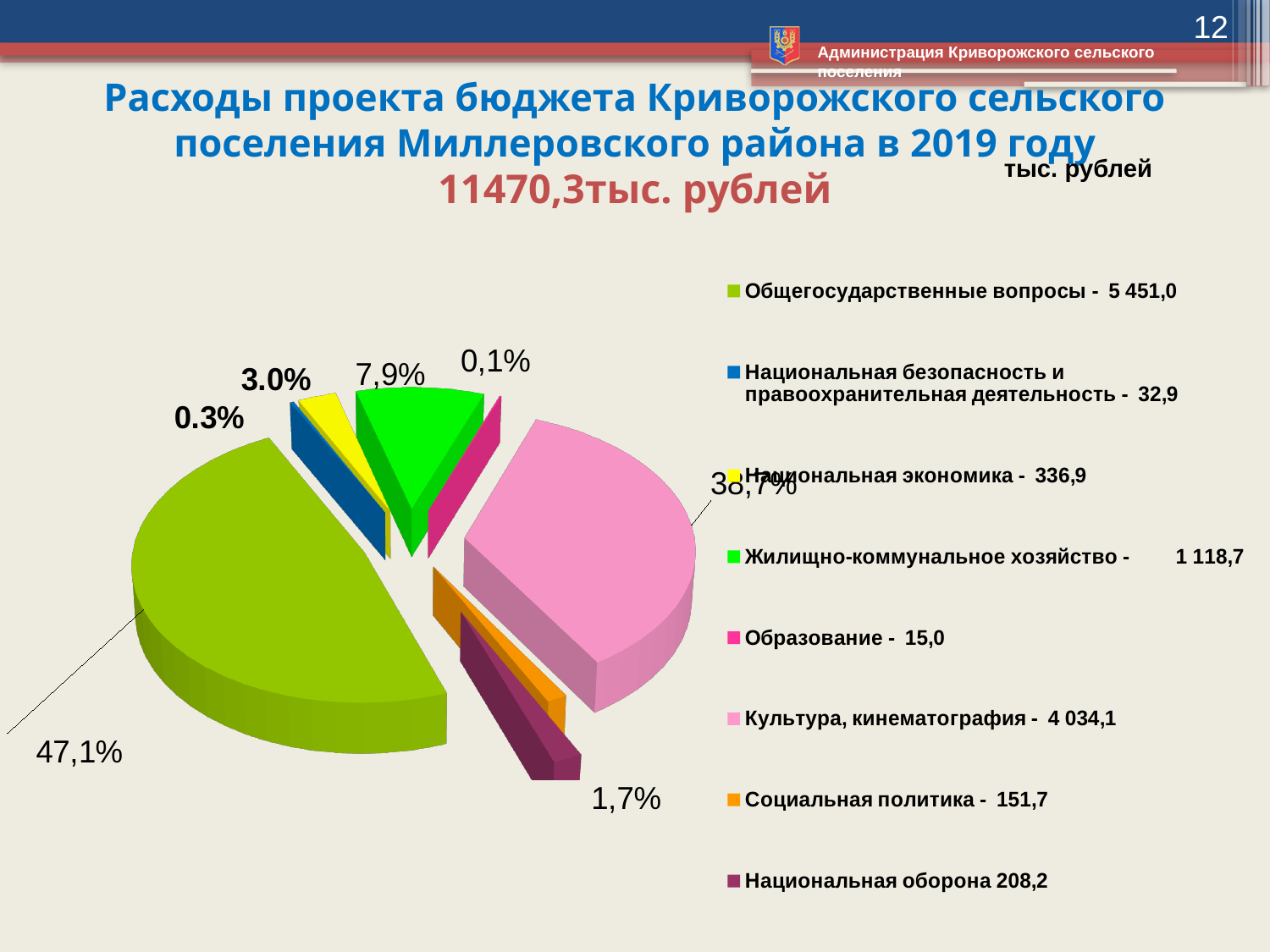
What share of the pie does Жилищно-коммунальное хозяйство take, according to its data label? 7,9% What value is given in the legend for Образование? 15,0 What kind of chart is shown on the slide? pie chart Which category has the smallest value in the pie chart? Образование What value is given in the legend for Общегосударственные вопросы? 5 451,0 How many categories does the legend of the pie chart list? 8 What total amount of expenditure is stated in the chart title? 11470,3 тыс. рублей What share of the pie does Общегосударственные вопросы take, according to its data label? 47,1% Which is larger, Национальная оборона or Социальная политика? Национальная оборона What value is given in the legend for Культура, кинематография? 4 034,1 What is the difference between the values for Общегосударственные вопросы and Культура, кинематография? 1 416,9 Which category has the largest value in the pie chart? Общегосударственные вопросы